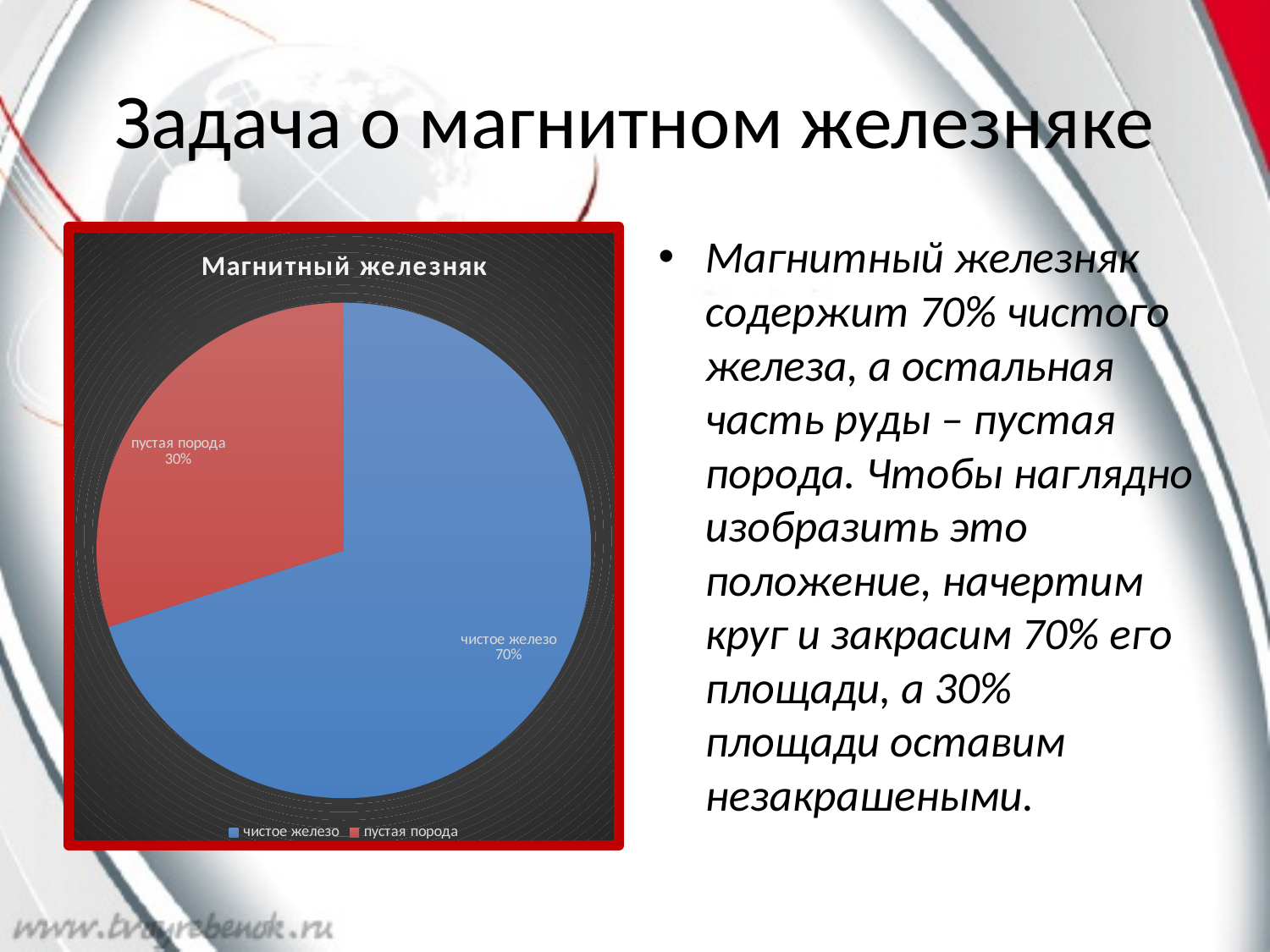
What is the title of the chart? Магнитный железняк What share of the pie does "чистое железо" take? 70% What share of the pie does "пустая порода" take? 30% Which slice of the pie is the largest? чистое железо What colour is the "пустая порода" slice? red What kind of chart is shown on the slide? pie chart Which slice of the pie is the smallest? пустая порода How many slices does the pie chart have? 2 What is the difference in percentage points between the "чистое железо" and "пустая порода" slices? 40% Which is larger, the "чистое железо" slice or the "пустая порода" slice? чистое железо How many entries does the legend list? 2